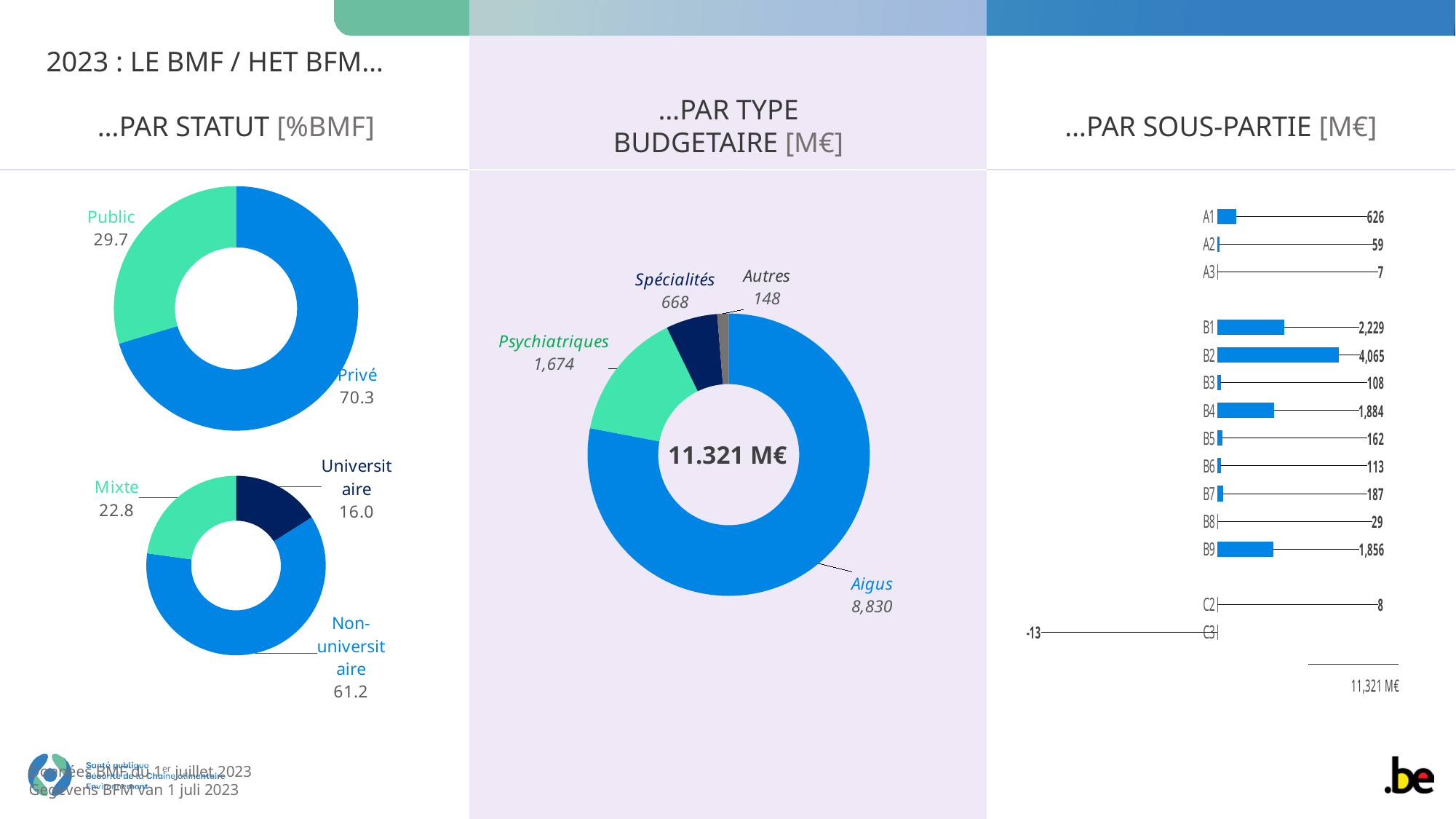
In the '...PAR TYPE BUDGETAIRE' donut chart, what is the value for Psychiatriques? 1,674 How many sub-parts are shown in the '...PAR SOUS-PARTIE' chart? 14 In the '...PAR SOUS-PARTIE' bar chart, what is the difference between B2 and B1? 1,836 In the bottom donut chart under '...PAR STATUT', what is the value for Mixte? 22.8 In the '...PAR SOUS-PARTIE' bar chart, which is larger, B1 or B9? B1 In the '...PAR TYPE BUDGETAIRE' donut chart, what is the difference between Aigus and Psychiatriques? 7,156 In the '...PAR SOUS-PARTIE' bar chart, which sub-part has the highest value? B2 What kind of chart is the '...PAR SOUS-PARTIE' chart? bar chart In the top donut chart under '...PAR STATUT', what is the value for Privé? 70.3 In the '...PAR SOUS-PARTIE' bar chart, which sub-part has the lowest value? C3 In the '...PAR SOUS-PARTIE' bar chart, what is the value for B4? 1,884 In the '...PAR TYPE BUDGETAIRE' donut chart, which category has the largest value? Aigus